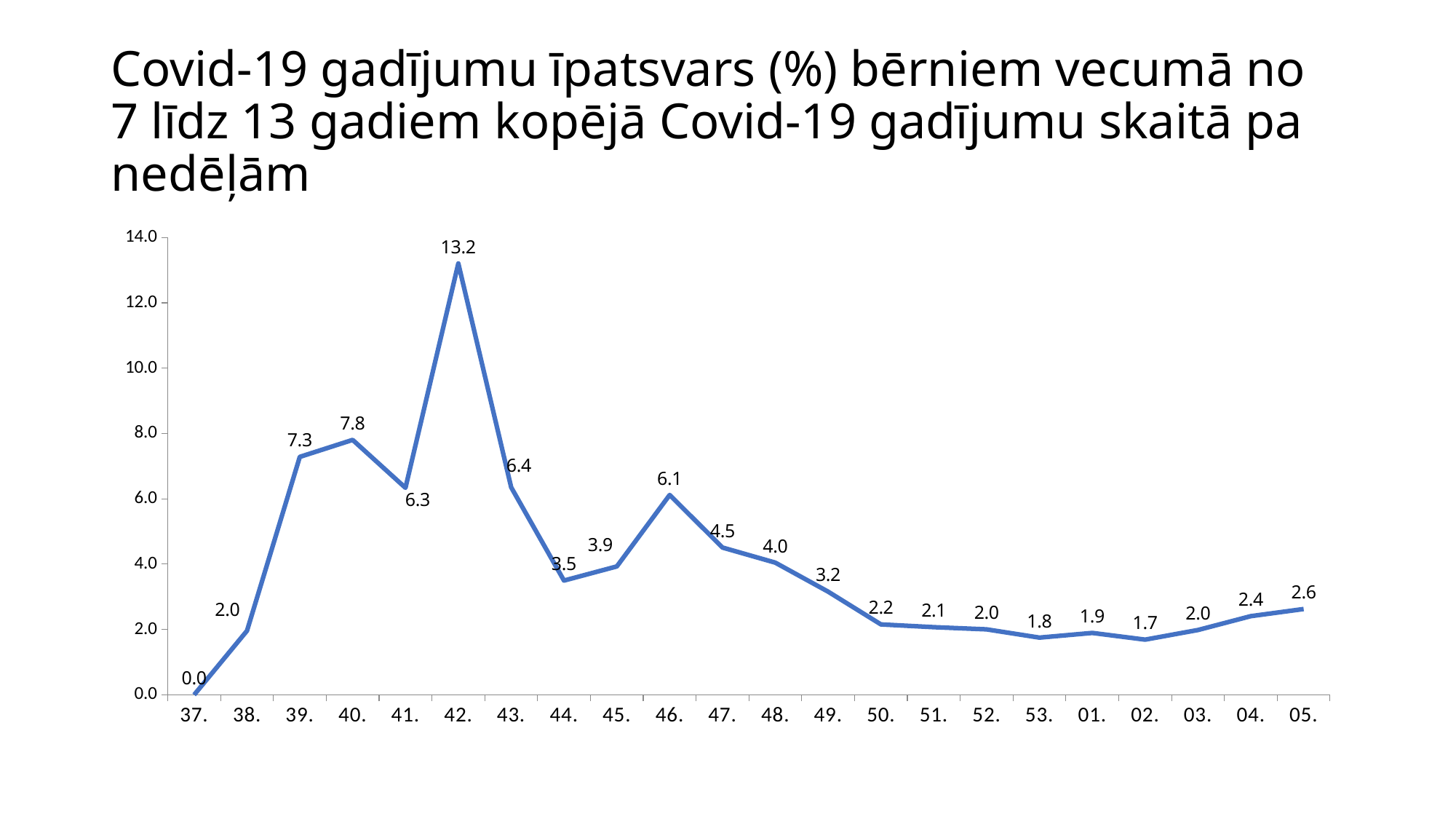
Do the values rise or fall from week 46. to week 50.? fall Which is larger, the value for week 39. or week 40.? 40. What kind of chart is shown? line chart What is the value for week 46.? 6.1 What is the value for week 05.? 2.6 Is the value for week 41. greater or less than 6.0? greater Which week has the lowest value? 37. What is the highest tick value shown on the y axis? 14.0 What is the value for week 42.? 13.2 What is the difference between the values for week 42. and week 43.? 6.8 How many weeks are plotted on the x axis? 22 Which week has the highest value? 42.